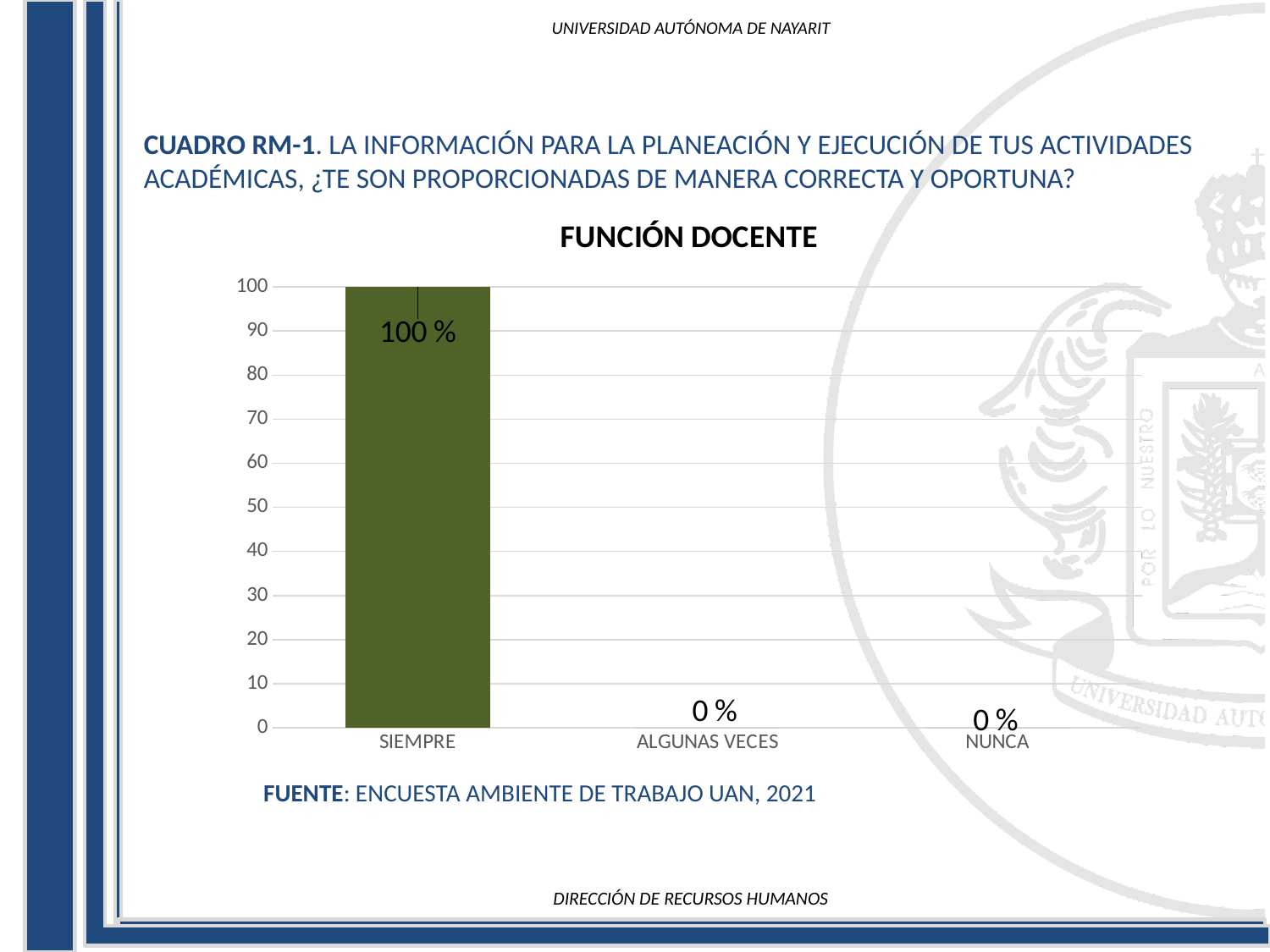
Which category has the highest value? SIEMPRE What kind of chart is shown? bar chart What is the title of the chart? FUNCIÓN DOCENTE What is the value for ALGUNAS VECES? 0 % What is the value for SIEMPRE? 100 % What is the value for NUNCA? 0 % Which is larger, the value for SIEMPRE or the value for NUNCA? SIEMPRE What is the difference between the values for SIEMPRE and ALGUNAS VECES? 100 % Is the value for SIEMPRE greater or less than 50? greater What is the maximum value shown on the y axis? 100 How many categories are shown on the x axis? 3